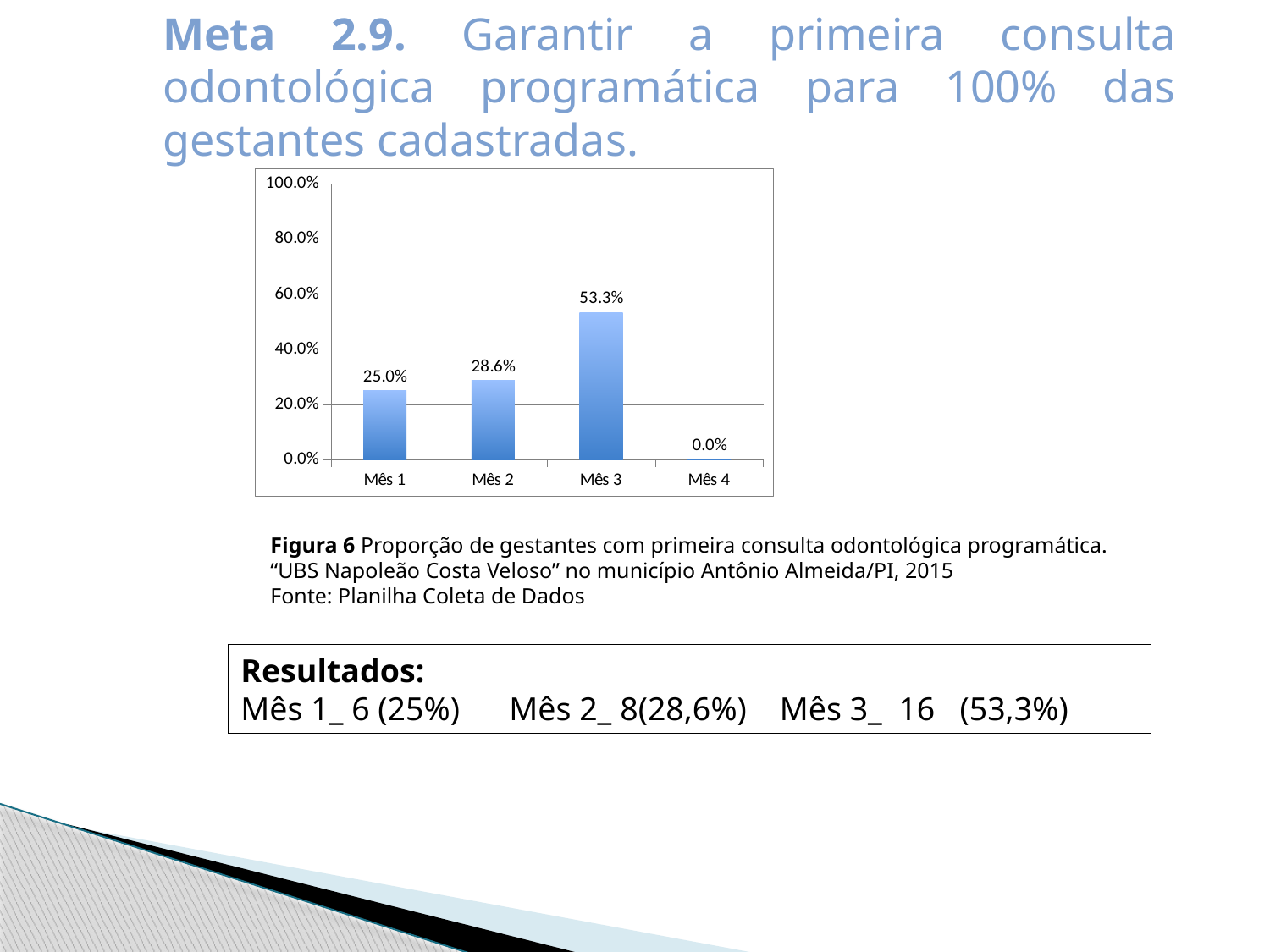
Which month has the lowest value? Mês 4 Which is larger, the value for Mês 1 or the value for Mês 3? Mês 3 What kind of chart is shown on the slide? bar chart What is the value for Mês 2? 28.6% What is the difference between the values for Mês 2 and Mês 1? 3.6% What is the value for Mês 4? 0.0% What is the difference between the values for Mês 3 and Mês 2? 24.7% How many categories are shown on the x axis? 4 What is the value for Mês 1? 25.0% What is the value for Mês 3? 53.3% Which month has the highest value? Mês 3 Is the value for Mês 3 greater or less than 40.0%? greater